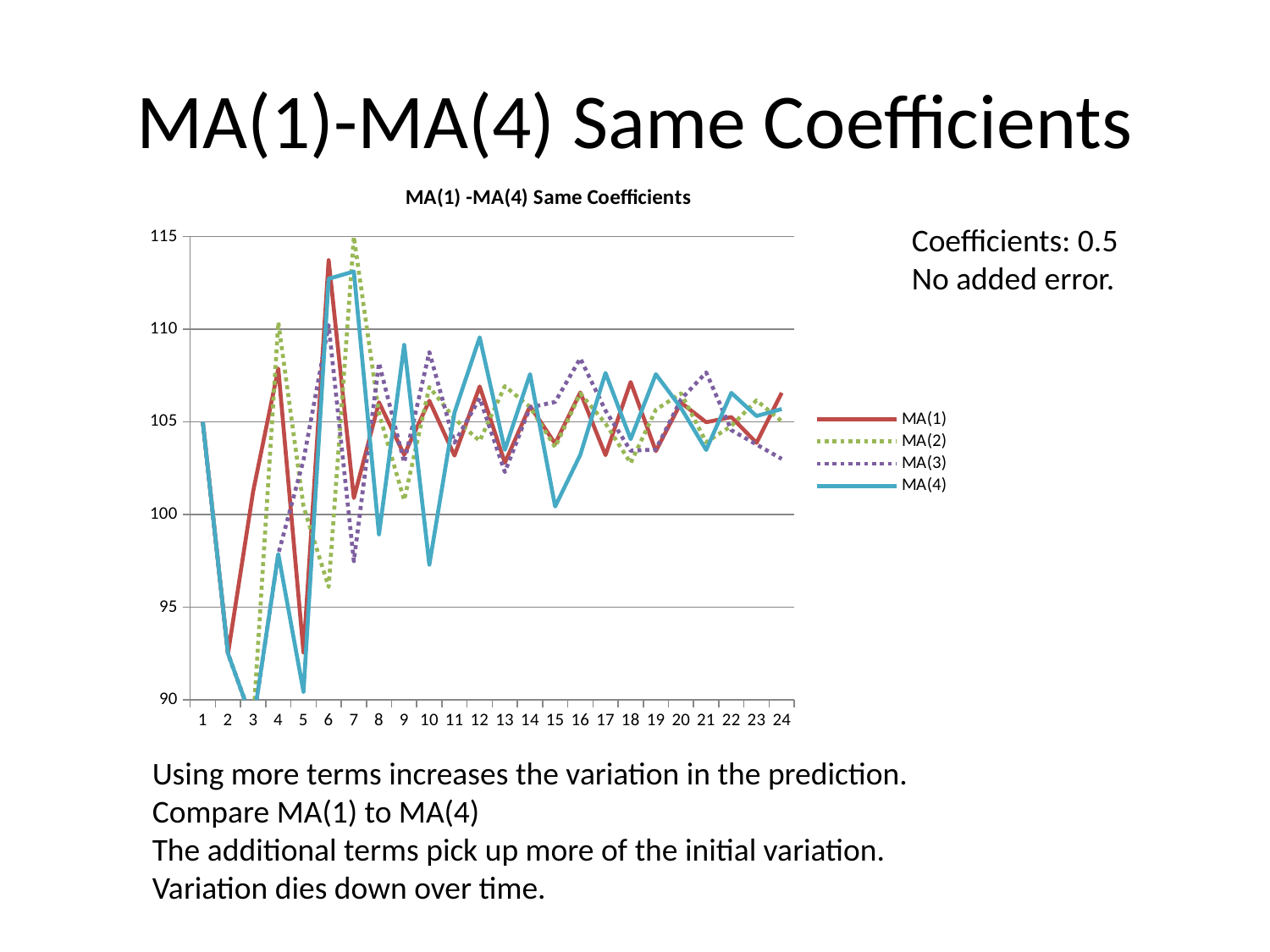
Is the value of MA(1) at point 2 greater or less than 95? less What is the title of the chart? MA(1) -MA(4) Same Coefficients Which series is drawn as a solid red line? MA(1) Is the value of MA(3) at point 7 greater or less than 100? less Is the value of MA(4) at point 10 greater or less than 100? less At point 3, which series has the larger value, MA(1) or MA(2)? MA(1) What kind of chart is shown on the slide? line chart How many points are plotted along the x axis? 24 How many series does the legend list? 4 At point 7, which series has the larger value, MA(2) or MA(3)? MA(2)